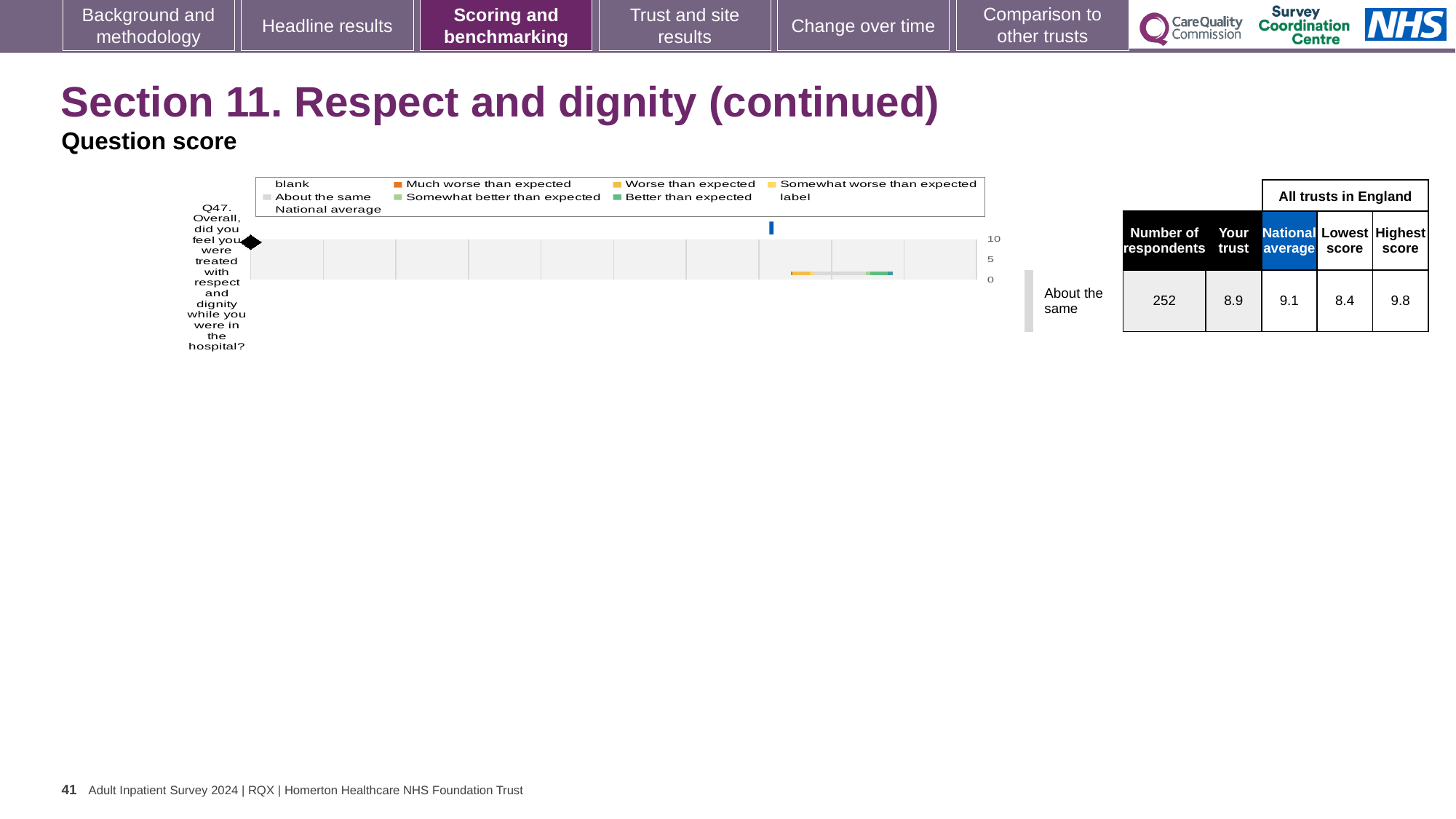
What benchmarking category is Q47 assigned on this slide? About the same According to the table beside the chart, how many respondents answered Q47? 252 What is the highest tick value shown on the chart's axis? 10 According to the table beside the chart, what is the highest score among all trusts in England for Q47? 9.8 Which legend entry is shown in dark green? Better than expected How many questions are plotted on the chart? 1 Is the 'Your trust' score for Q47 higher or lower than the national average? lower According to the table beside the chart, what is the national average score for Q47? 9.1 According to the table beside the chart, what is the 'Your trust' score for Q47? 8.9 What is the difference between the highest score and the lowest score for Q47 in the table? 1.4 What kind of chart is used to show the Q47 question score? bar chart According to the table beside the chart, what is the lowest score among all trusts in England for Q47? 8.4